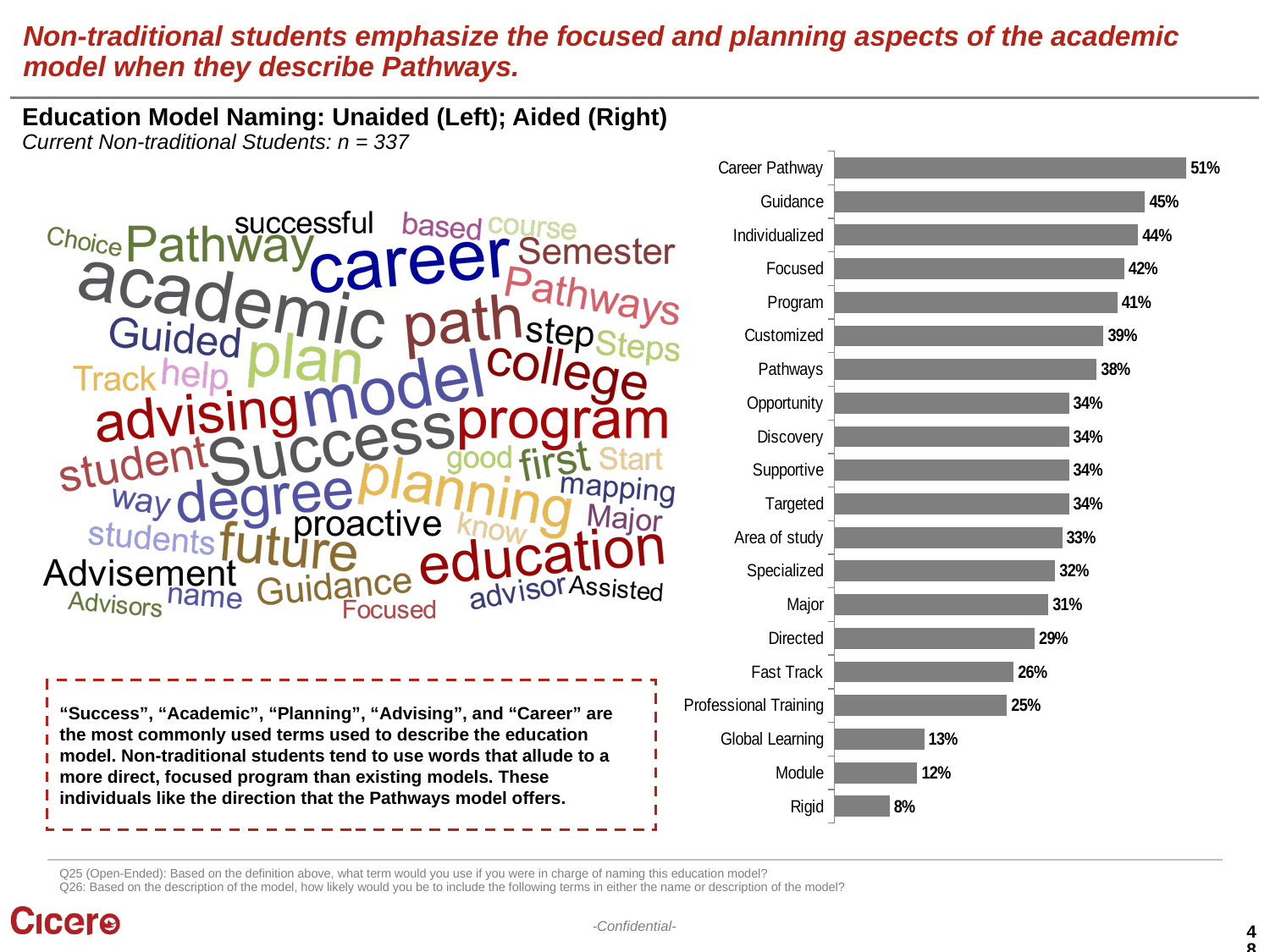
In the bar chart on the right, what percentage is shown for Career Pathway? 51% How many terms are listed in the bar chart on the right? 20 In the bar chart on the right, which term has the lowest percentage? Rigid What is the sample size (n) stated in the subtitle of the slide? 337 In the bar chart on the right, what is the value for Customized? 39% In the bar chart on the right, what is the difference between the values for Career Pathway and Rigid? 43% In the bar chart on the right, which has a higher value, Directed or Fast Track? Directed In the bar chart on the right, which term has the highest percentage? Career Pathway In the bar chart on the right, which has a higher value, Global Learning or Module? Global Learning In the bar chart on the right, what is the difference between the values for Guidance and Focused? 3% In the bar chart on the right, what percentage is shown for Professional Training? 25% What type of chart is shown on the right side of the slide? Bar chart